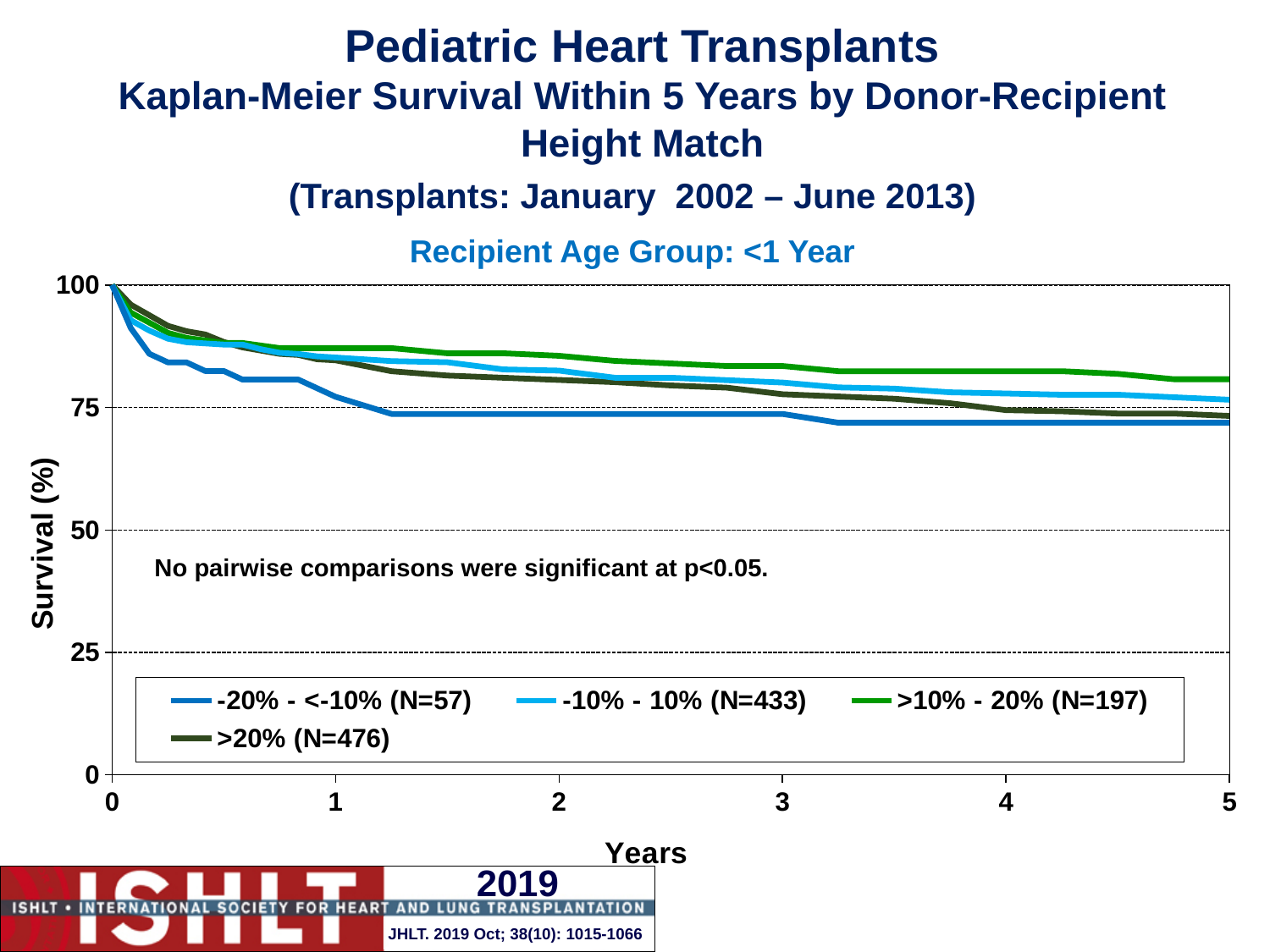
At year 5, which group has higher survival: >10% - 20% or -20% - <-10%? >10% - 20% What is the label of the y axis? Survival (%) Which height-match group has the highest survival at year 5? >10% - 20% (N=197) Is the survival value for the -20% - <-10% group at year 5 greater or less than 75? less Is the survival value for the >10% - 20% group at year 3 greater or less than 75? greater What is the N for the >20% height-match group in the legend? 476 What kind of chart is shown on the slide? line chart Do the survival curves rise or fall as years increase? fall At year 2, which group has higher survival: -10% - 10% or -20% - <-10%? -10% - 10% What is the survival value for all groups at year 0? 100 How many series does the legend list? 4 Which height-match group has the lowest survival at year 2? -20% - <-10% (N=57)